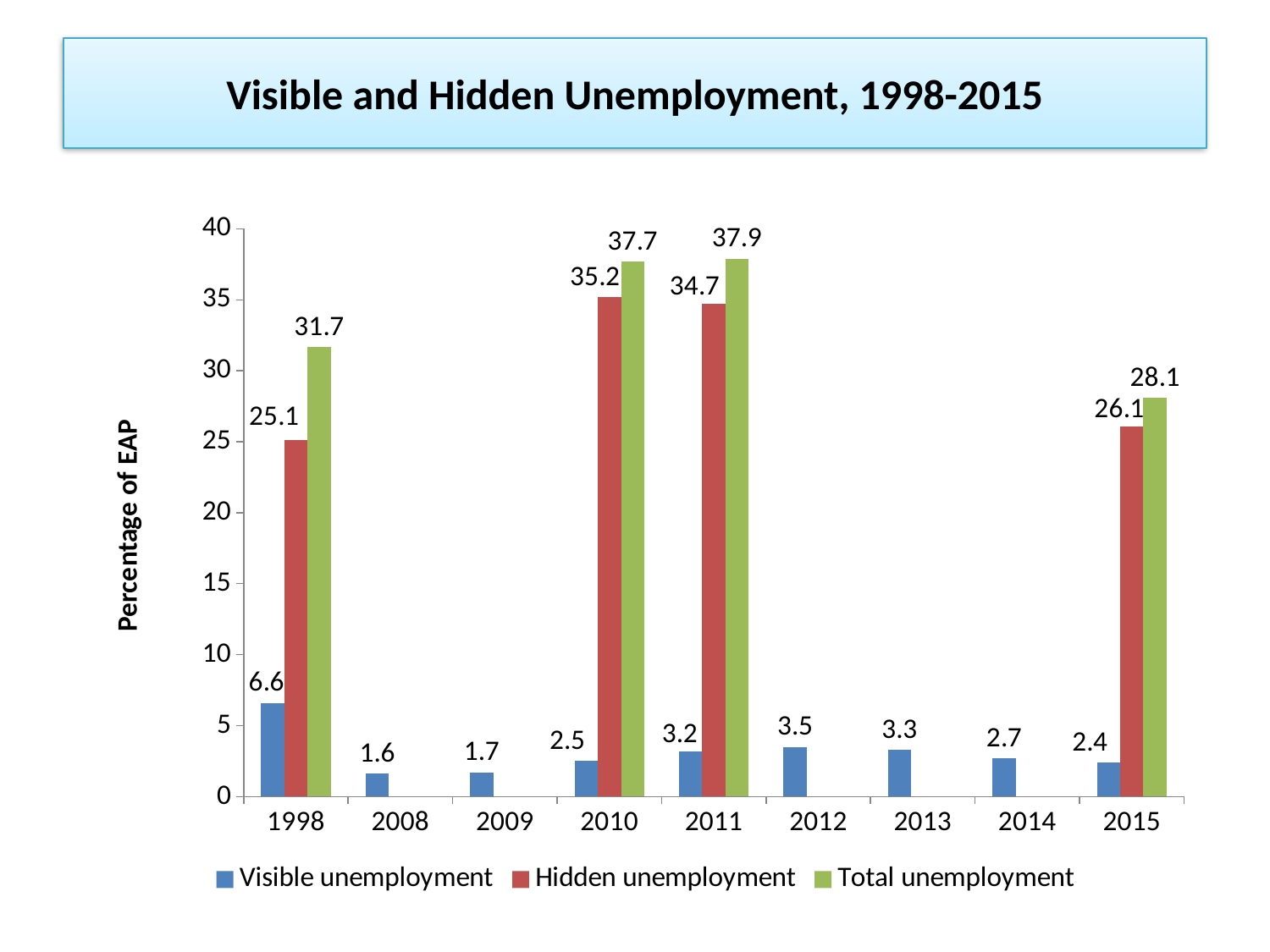
Which is larger, the Visible unemployment value for 2012 or for 2014? 2012 What is the label of the vertical axis? Percentage of EAP What kind of chart is shown on the slide? bar chart What is the Visible unemployment value for 1998? 6.6 What is the Total unemployment value for 2015? 28.1 What is the difference between Total unemployment and Hidden unemployment in 2010? 2.5 What is the Hidden unemployment value for 2011? 34.7 How many series does the legend list? 3 How many years are shown on the x axis? 9 Is the Hidden unemployment value for 1998 greater or less than 30? less Which year has the highest Total unemployment value? 2011 Which year has the lowest Visible unemployment value? 2008